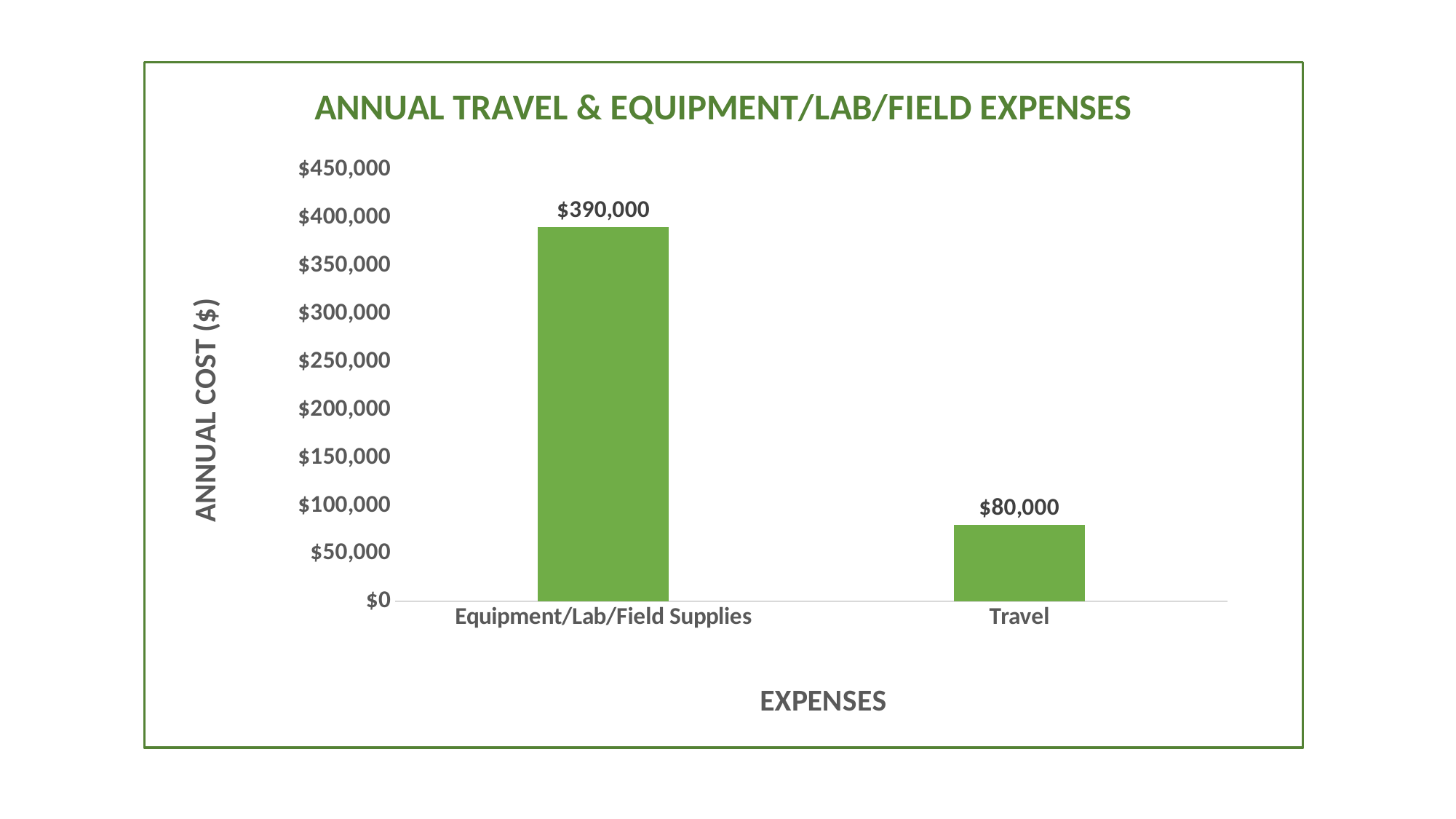
What is the title of the chart? ANNUAL TRAVEL & EQUIPMENT/LAB/FIELD EXPENSES Which expense category has the highest annual cost? Equipment/Lab/Field Supplies What is the difference between the Equipment/Lab/Field Supplies cost and the Travel cost? $310,000 Is the value for Travel greater or less than $100,000? less Which is larger, the cost for Travel or the cost for Equipment/Lab/Field Supplies? Equipment/Lab/Field Supplies What is the annual cost for Equipment/Lab/Field Supplies? $390,000 What is the annual cost for Travel? $80,000 What kind of chart is shown on the slide? Bar chart What is the label on the vertical axis of the chart? ANNUAL COST ($) How many expense categories are shown in the chart? 2 Is the value for Equipment/Lab/Field Supplies greater or less than $350,000? greater Which expense category has the lowest annual cost? Travel